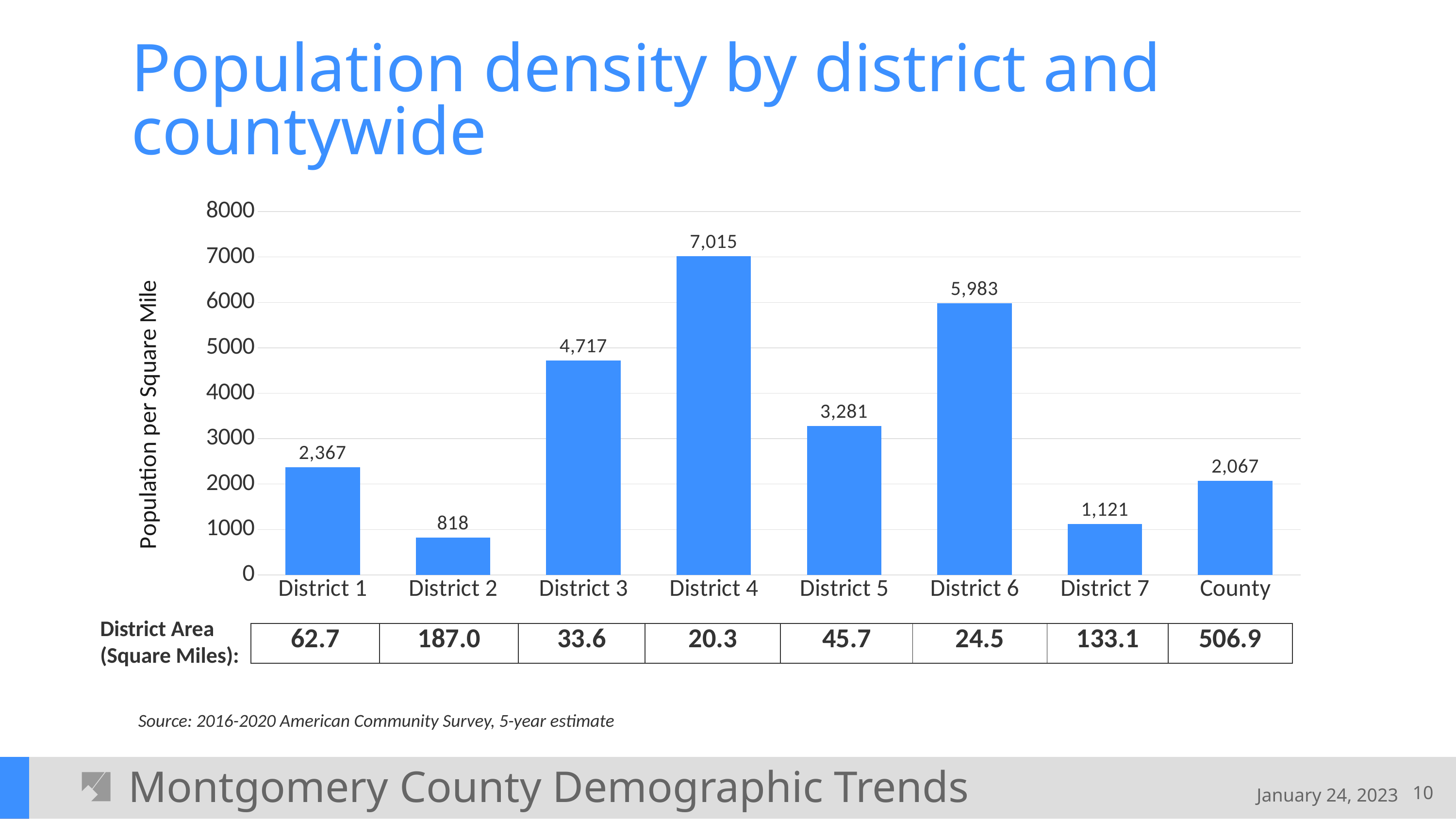
Which category has the highest population density? District 4 What is the label of the vertical axis? Population per Square Mile What is the difference in population per square mile between District 4 and District 6? 1,032 Which has a higher population density, District 3 or District 5? District 3 How many categories are shown on the x axis of the chart? 8 What is the countywide population per square mile shown in the chart? 2,067 What kind of chart is shown on the slide? bar chart What is the population per square mile for District 2? 818 Which category has the lowest population density? District 2 What is the population per square mile for District 4? 7,015 What is the difference in population per square mile between District 1 and the County? 300 Is the value for District 7 greater or less than 2000? less